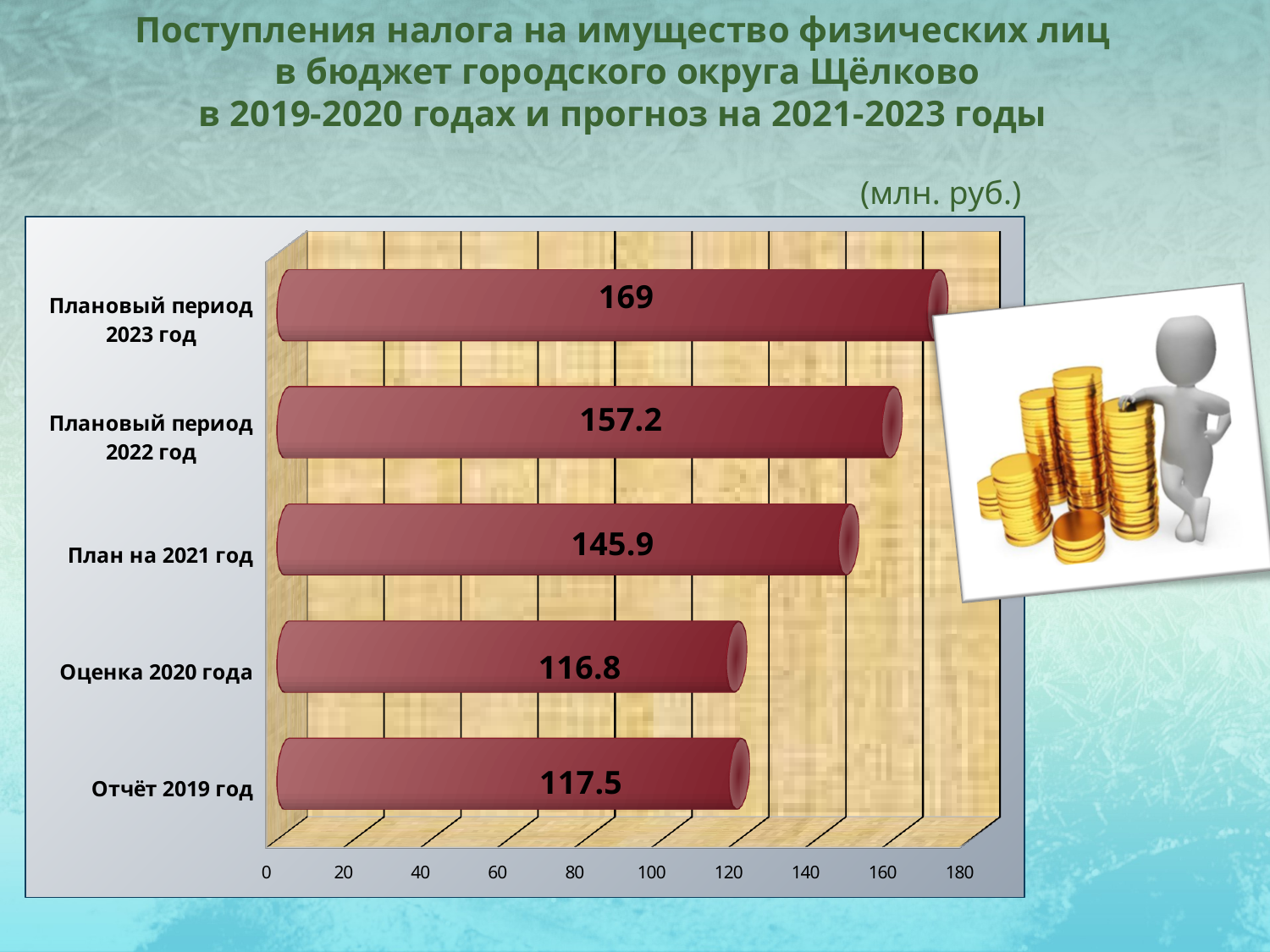
What is the value for Оценка 2020 года? 116.8 Which is larger, the value for План на 2021 год or the value for Оценка 2020 года? План на 2021 год How many categories are shown in the chart? 5 What is the difference between the values for Плановый период 2023 год and Плановый период 2022 год? 11.8 Which category has the highest value? Плановый период 2023 год What unit of measurement is indicated for the chart values? млн. руб. What is the difference between the values for Отчёт 2019 год and Оценка 2020 года? 0.7 Which category has the lowest value? Оценка 2020 года What is the value for Плановый период 2022 год? 157.2 What is the value for Отчёт 2019 год? 117.5 What is the value for План на 2021 год? 145.9 What kind of chart is shown on the slide? Bar chart